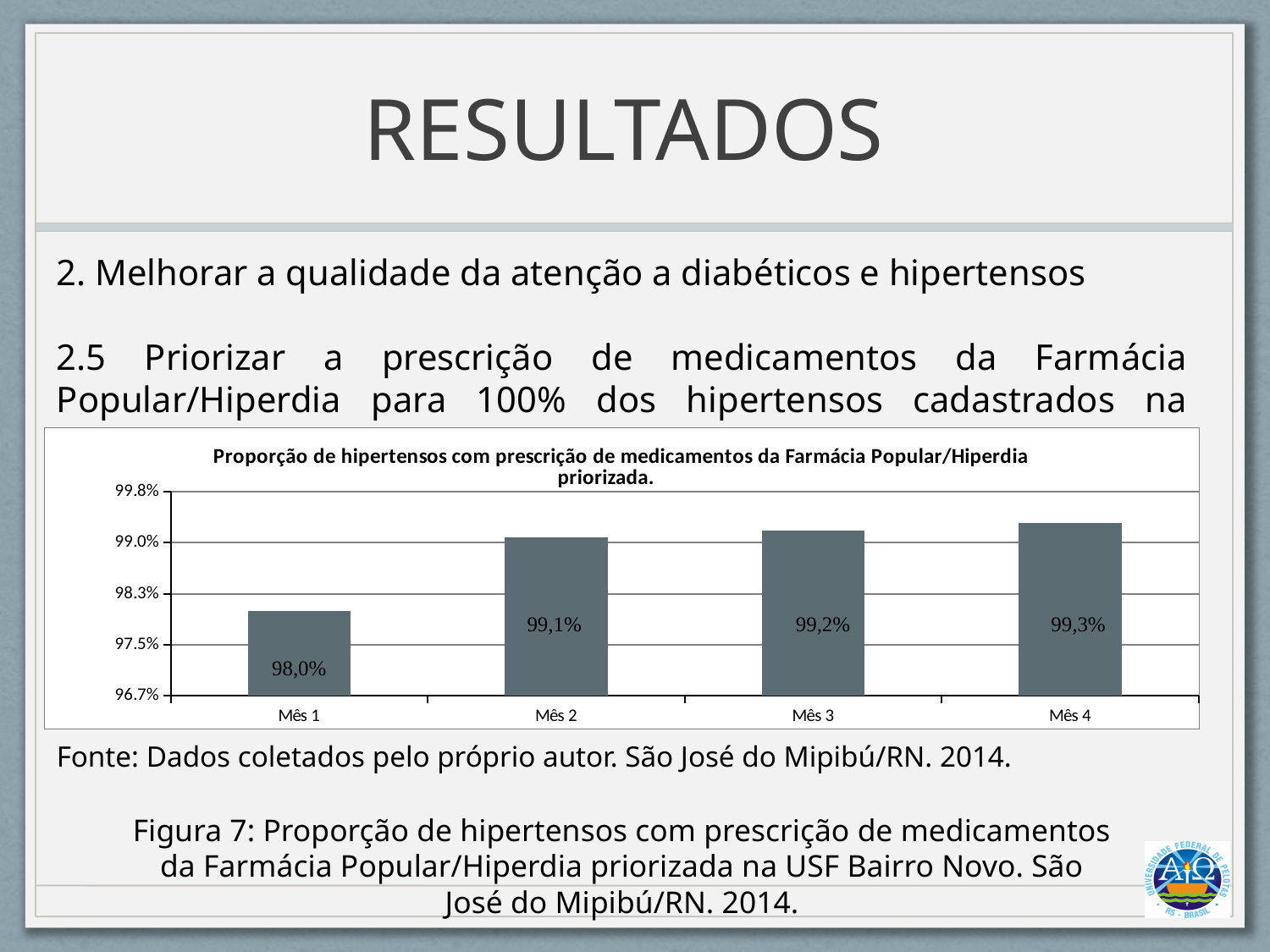
Do the values rise or fall from Mês 1 to Mês 4? rise Is the value for Mês 1 greater or less than 98.3%? less Which is larger, the value for Mês 2 or the value for Mês 4? Mês 4 What is the value for Mês 4? 99,3% Which month has the lowest proportion? Mês 1 What is the value for Mês 1? 98,0% Which month has the highest proportion? Mês 4 What is the title of the chart? Proporção de hipertensos com prescrição de medicamentos da Farmácia Popular/Hiperdia priorizada. What is the difference between the values for Mês 4 and Mês 1? 1,3% How many months (categories) are shown on the x axis? 4 What is the value for Mês 3? 99,2% What type of chart is shown on the slide? bar chart